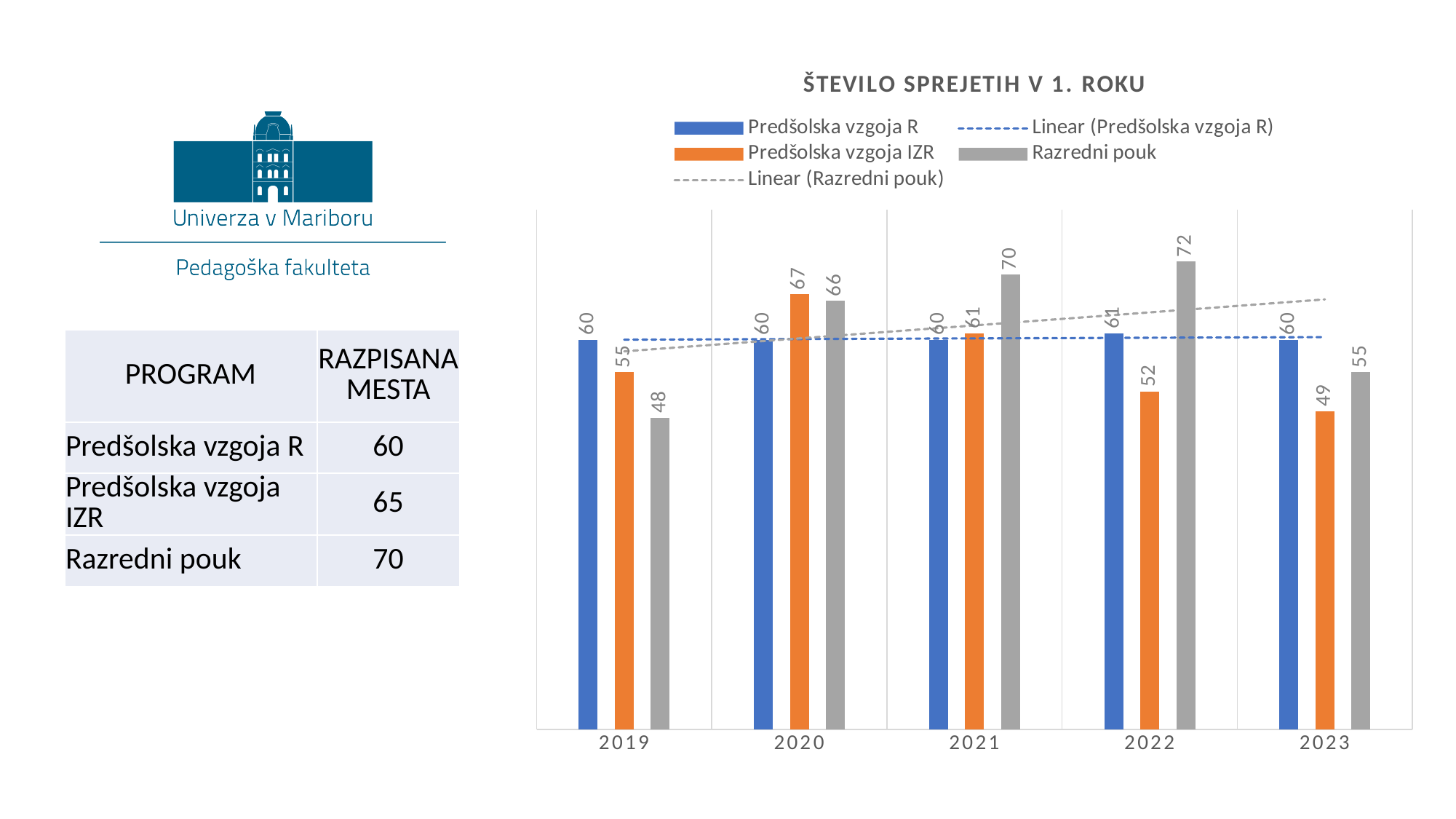
What kind of chart is shown on the slide? bar chart What is the difference between the Razredni pouk values in 2022 and 2019? 24 Does the value for Razredni pouk rise or fall from 2019 to 2022? rise What is the value for Predšolska vzgoja IZR in 2020? 67 In which year is the value for Predšolska vzgoja IZR lowest? 2023 Which is larger in 2023: Predšolska vzgoja IZR or Razredni pouk? Razredni pouk How many entries does the chart legend list? 5 What is the title of the chart? ŠTEVILO SPREJETIH V 1. ROKU How many years are shown on the x axis of the chart? 5 What is the value for Razredni pouk in 2019? 48 In which year is the value for Razredni pouk highest? 2022 What is the value for Predšolska vzgoja R in 2022? 61